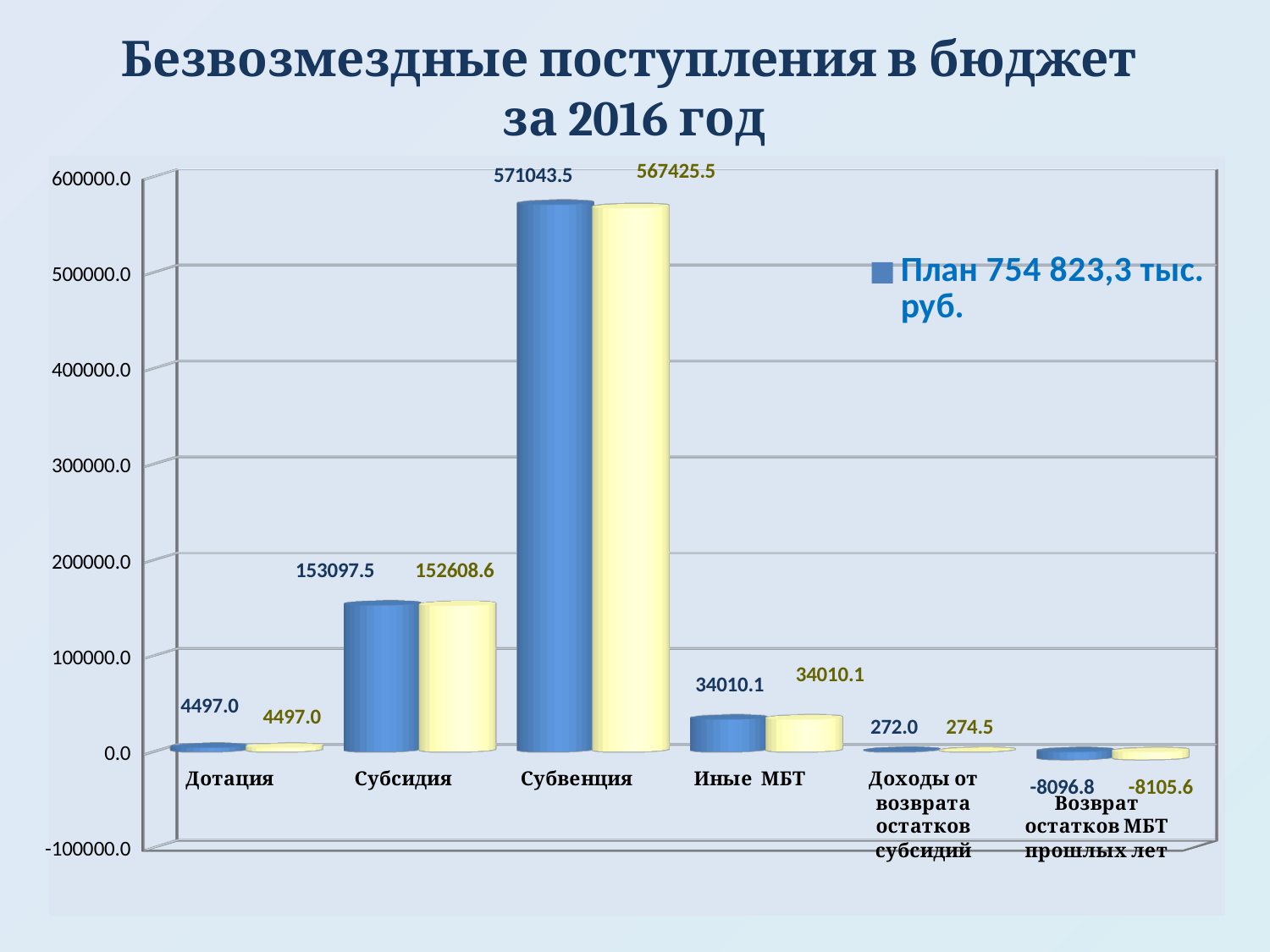
What kind of chart is shown on the slide? bar chart What is the difference between the blue (План) bar and the yellow bar for Субсидия? 488.9 In the blue (План) series, which is larger: Субсидия or Иные МБТ? Субсидия What is the value of the blue (План) bar for Дотация? 4497.0 Which category has the highest value in the blue (План) series? Субвенция What is the value of the yellow bar for Субсидия? 152608.6 Is the blue (План) value for Иные МБТ greater or less than 100000.0? less What is the value of the blue (План) bar for Субвенция? 571043.5 How many categories are shown on the x axis of the chart? 6 What is the difference between the blue (План) bar and the yellow bar for Субвенция? 3618.0 What is the value of the yellow bar for Доходы от возврата остатков субсидий? 274.5 Which category has the lowest value in the blue (План) series? Возврат остатков МБТ прошлых лет